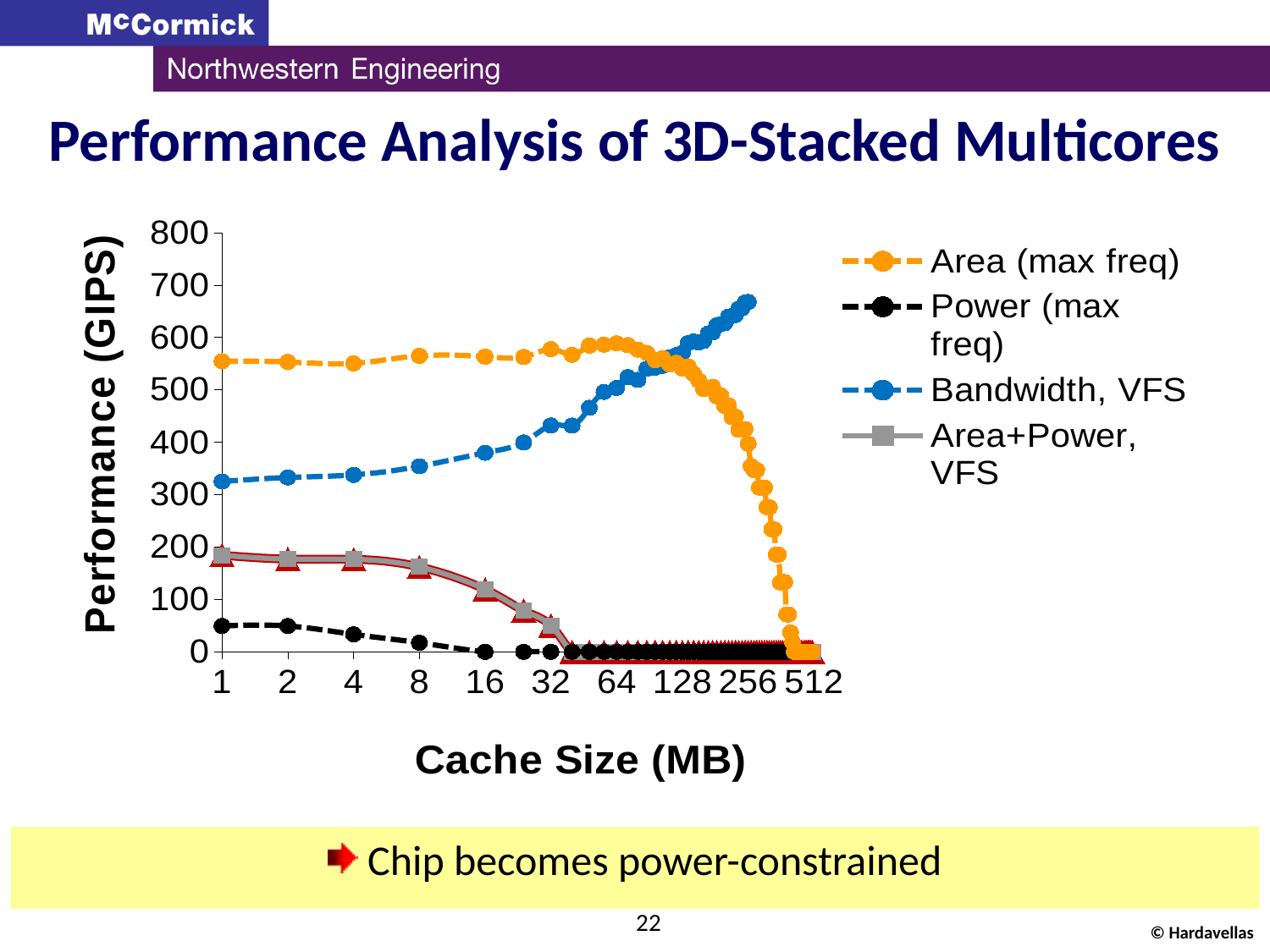
Is the value for Area+Power, VFS at a cache size of 1 MB greater or less than 200? less Does the Bandwidth, VFS series rise or fall as cache size increases? rise What kind of chart is shown on the slide? line chart Which series has the lowest value at a cache size of 1 MB? Power (max freq) Is the value for Area (max freq) at a cache size of 1 MB greater or less than 500? greater Is the value for Bandwidth, VFS at a cache size of 1 MB greater or less than 300? greater What is the title of the slide containing the chart? Performance Analysis of 3D-Stacked Multicores What is the label of the chart's vertical axis? Performance (GIPS) How many series does the chart's legend list? 4 At a cache size of 1 MB, which is larger: Area (max freq) or Bandwidth, VFS? Area (max freq) At a cache size of 256 MB, which is larger: Bandwidth, VFS or Area (max freq)? Bandwidth, VFS